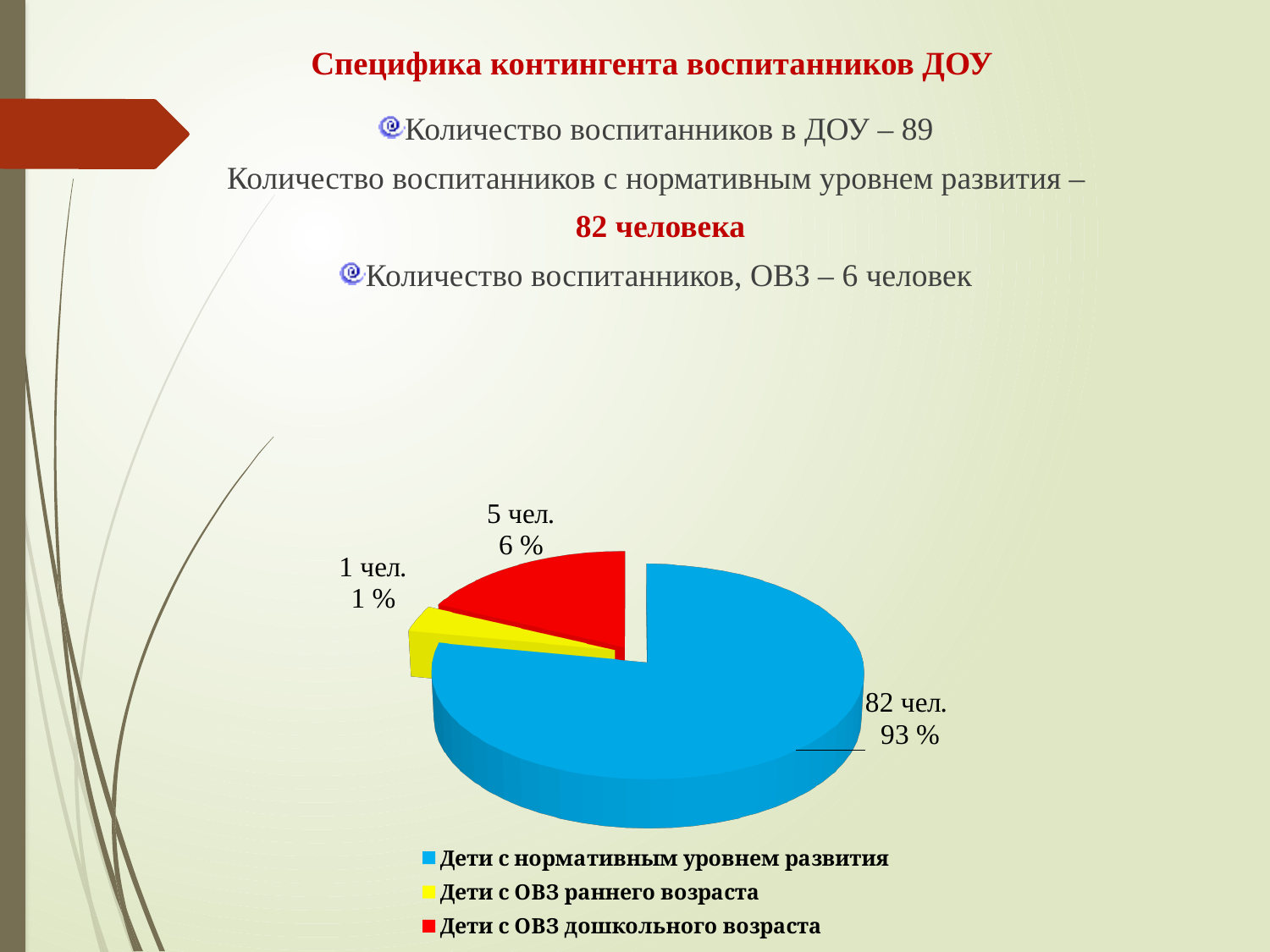
How many children are in the slice 'Дети с ОВЗ дошкольного возраста'? 5 чел. How many children are in the slice 'Дети с ОВЗ раннего возраста'? 1 чел. What kind of chart is shown on the slide? pie chart What is the difference in number of children between 'Дети с ОВЗ дошкольного возраста' and 'Дети с ОВЗ раннего возраста'? 4 чел. Which slice of the pie chart is the smallest? Дети с ОВЗ раннего возраста How many slices does the pie chart have? 3 Which colour represents 'Дети с ОВЗ дошкольного возраста' in the pie chart? red What percentage share does the slice 'Дети с ОВЗ дошкольного возраста' have? 6 % How many entries does the legend of the pie chart list? 3 How many children are in the slice 'Дети с нормативным уровнем развития'? 82 чел. What percentage share does the slice 'Дети с нормативным уровнем развития' have? 93 % Which slice of the pie chart is the largest? Дети с нормативным уровнем развития